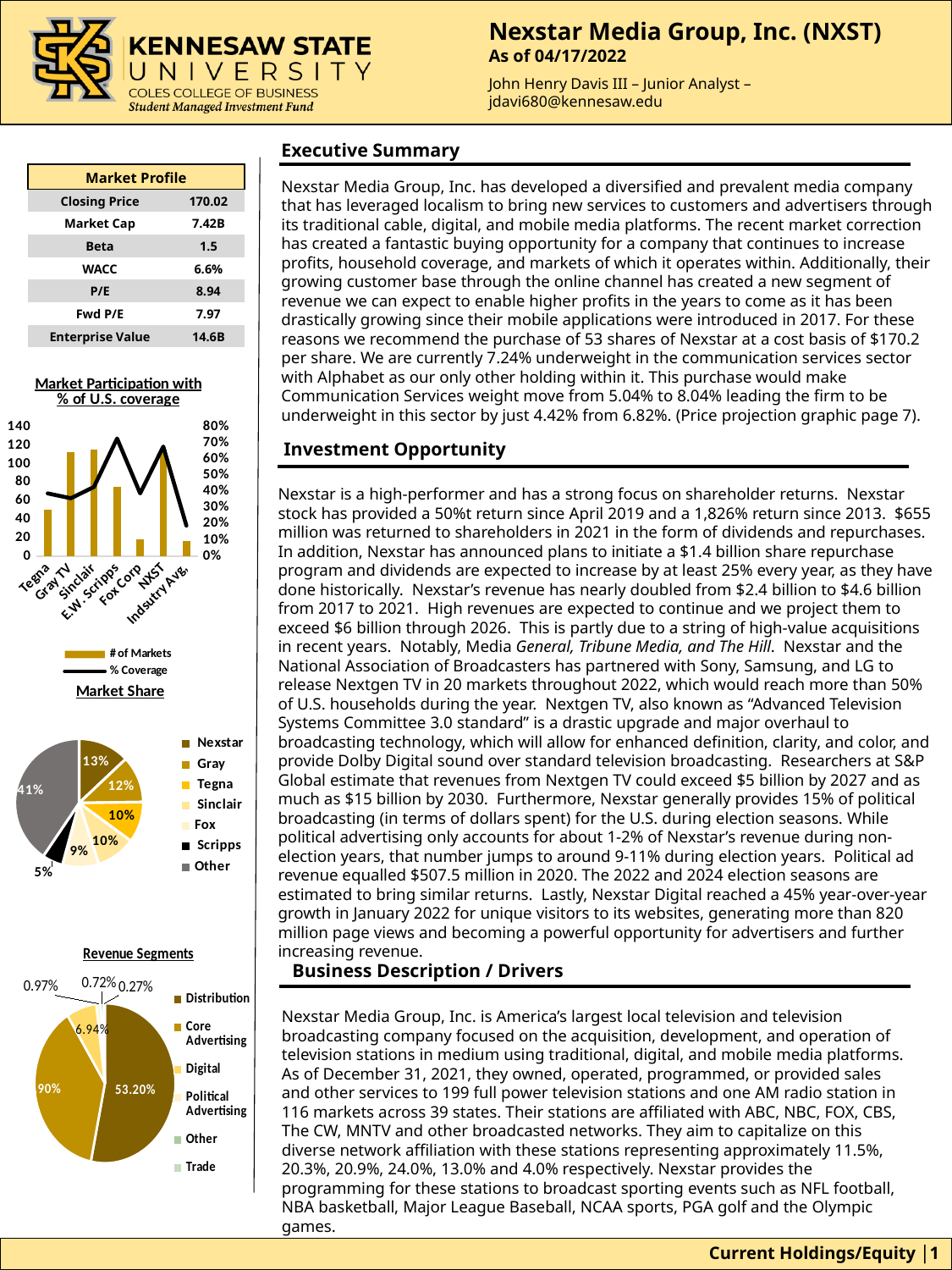
How many series does the legend of the Market Participation with % of U.S. coverage chart list? 2 In the Market Share pie chart, which slice is the largest? Other In the Market Share pie chart, what share is labelled for Other? 41% In the Market Share pie chart, which named company has the smallest slice? Scripps What kind of chart is the Market Participation with % of U.S. coverage chart? Bar and line chart In the Market Share pie chart, what share does Nexstar hold? 13% In the Market Share pie chart, how much larger is Nexstar's share than Gray's? 1% In the Revenue Segments pie chart, what percentage is shown for Digital? 6.94% How many entries does the legend of the Market Share pie chart list? 7 In the Revenue Segments pie chart, which segment is the largest? Distribution In the Revenue Segments pie chart, what percentage is shown for Distribution? 53.20% In the Market Participation with % of U.S. coverage chart, is the # of Markets bar for Gray TV greater or less than 80? greater